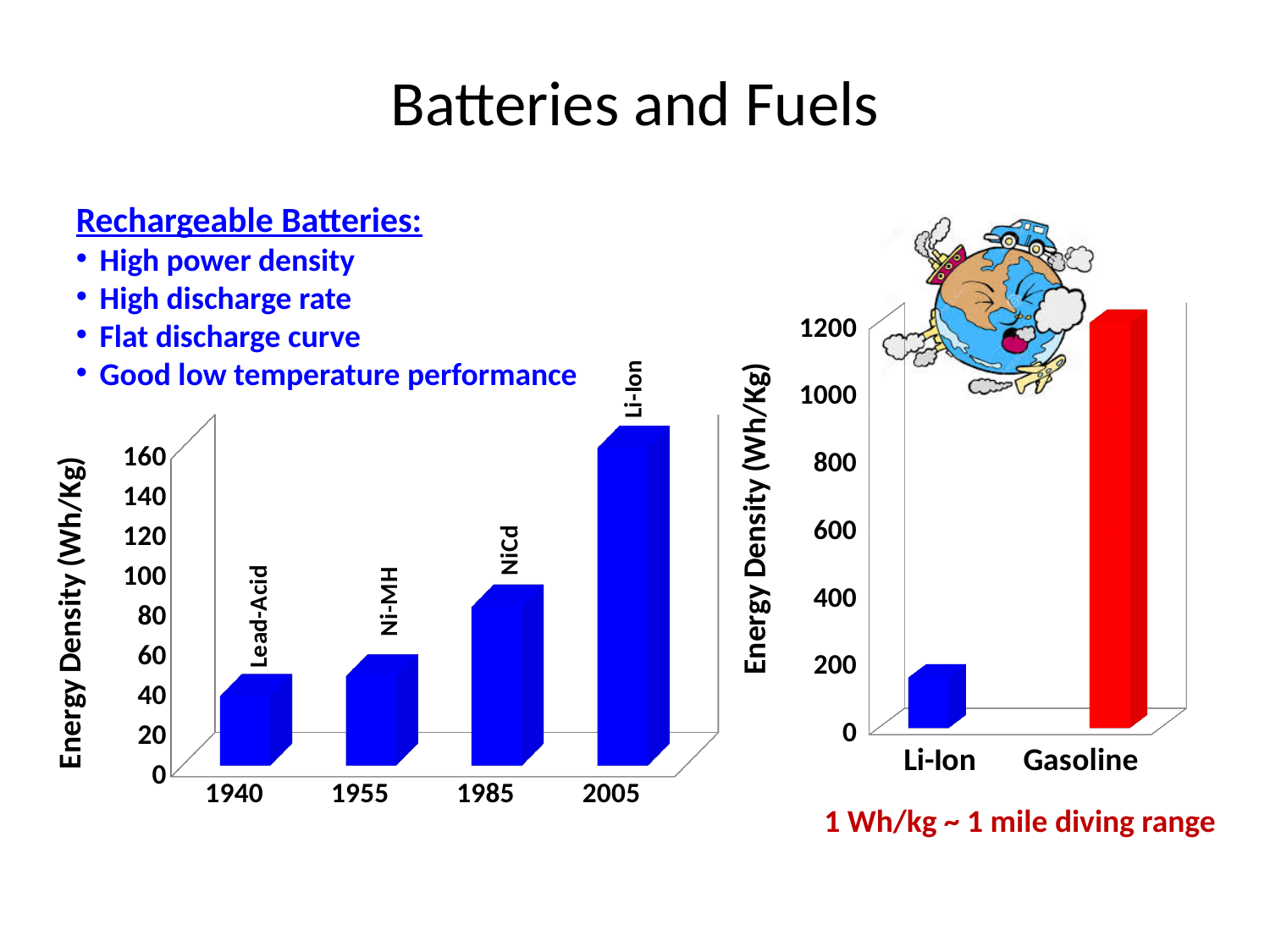
On the left chart, which is larger, the value for NiCd or the value for Ni-MH? NiCd On the right chart, is the value for Li-Ion greater or less than 400? less On the right chart, is the value for Gasoline greater or less than 1000? greater On the right chart, which category has the higher energy density? Gasoline What kind of chart is the chart on the right comparing Li-Ion and Gasoline? bar chart On the left chart, which battery type has the lowest energy density? Lead-Acid On the left chart, is the value for Li-Ion (2005) greater or less than 120? greater On the left chart, which year has the highest energy density? 2005 On the left chart, how many bars are plotted? 4 What is the y-axis label of the right chart? Energy Density (Wh/Kg) On the left chart, do the energy density values rise or fall from 1940 to 2005? rise